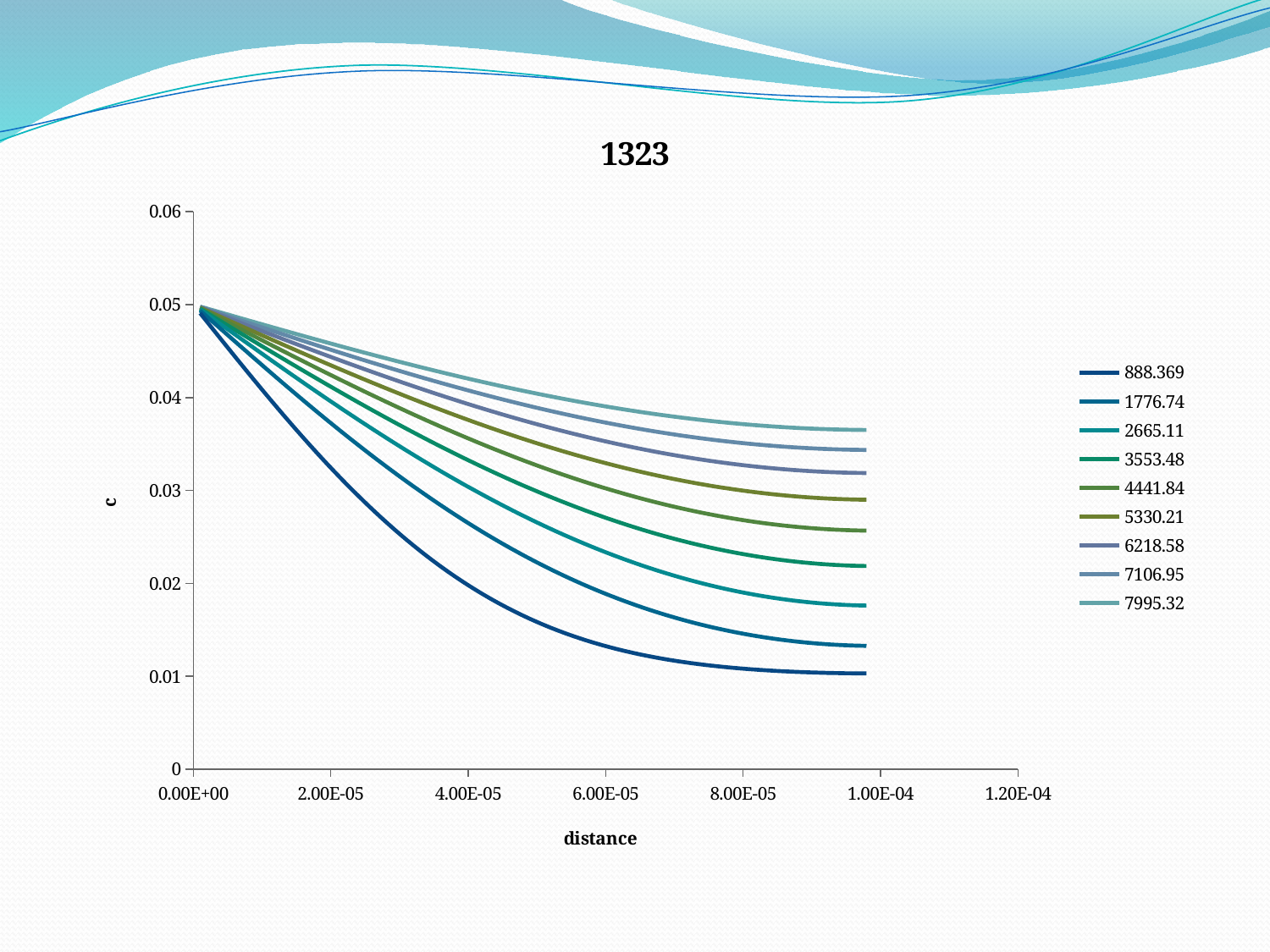
How many series does the legend list? 9 Do the values of the series rise or fall as distance increases? fall Which series has the highest value at the right end of the chart? 7995.32 What is the title of the chart? 1323 Is the value of the 888.369 series at the right end of the chart greater or less than 0.02? less At the right end of the chart, which series has the larger value, 888.369 or 7995.32? 7995.32 At the right end of the chart, which series has the larger value, 1776.74 or 4441.84? 4441.84 What is the label of the x axis? distance What kind of chart is shown on the slide? line chart Which series has the lowest value at the right end of the chart? 888.369 Is the value of the 7995.32 series at the right end of the chart greater or less than 0.03? greater